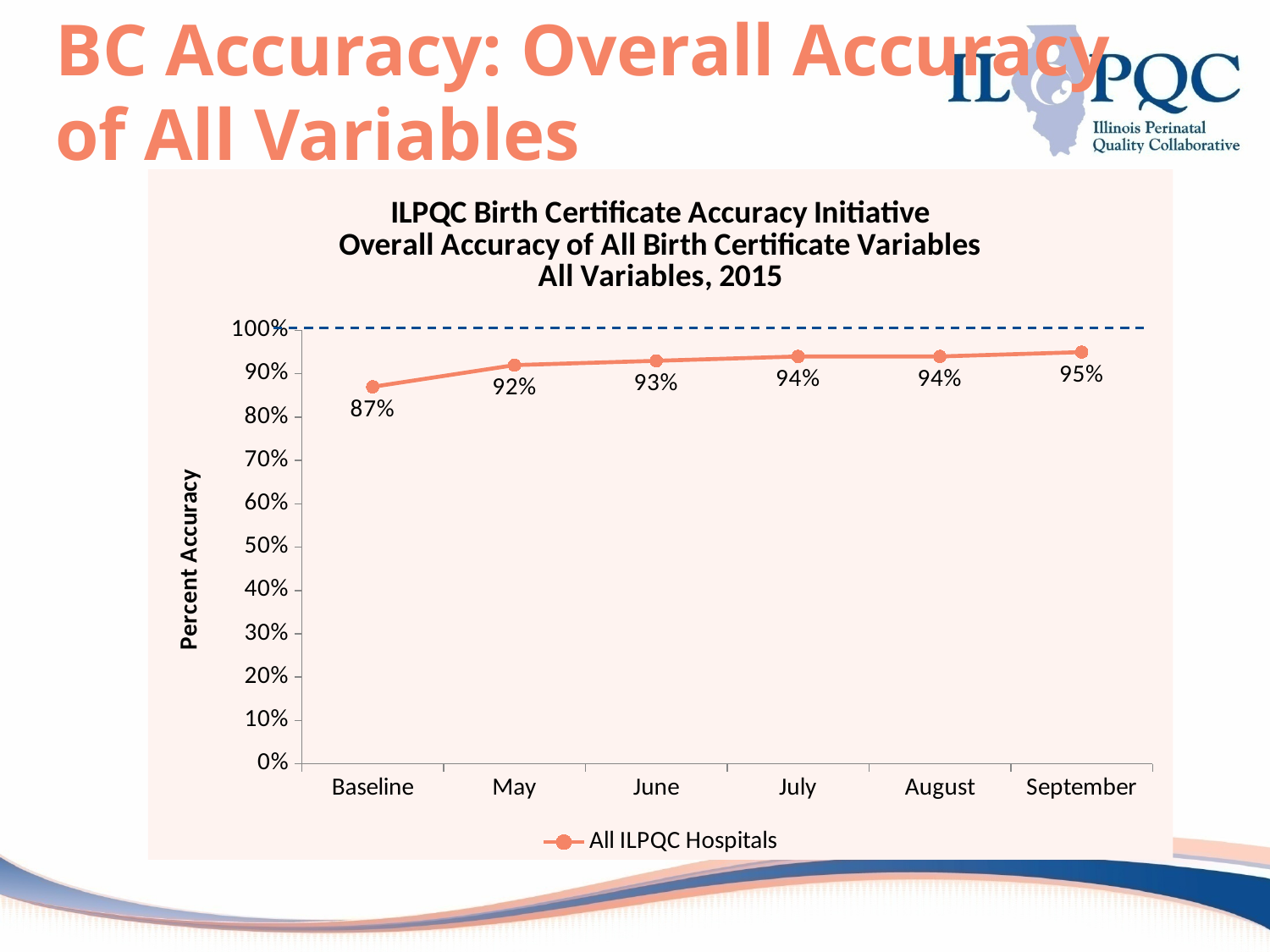
Which time point has the highest percent accuracy? September Is the percent accuracy at Baseline greater or less than 90%? less What is the percent accuracy for All ILPQC Hospitals in September? 95% What is the difference in percent accuracy between September and Baseline? 8% What kind of chart is shown on the slide? line chart How many time points are plotted on the x axis? 6 Which time point has the lowest percent accuracy? Baseline Which has a higher percent accuracy, May or July? July What is the percent accuracy for All ILPQC Hospitals at Baseline? 87% Does the percent accuracy rise or fall from Baseline to September? rise What is the percent accuracy for All ILPQC Hospitals in June? 93% How many series does the legend list? 1